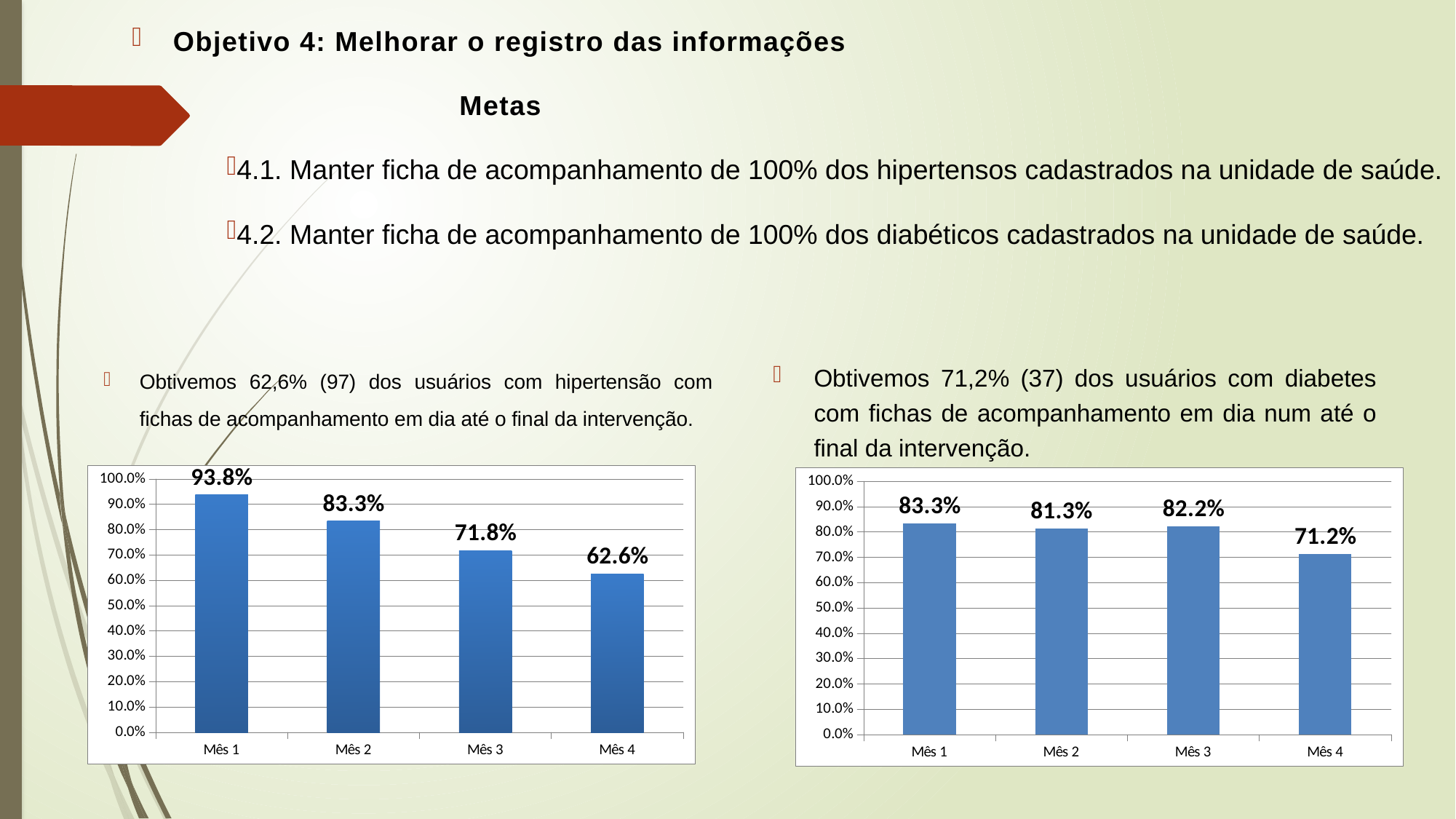
In the left chart, which month has the lowest value? Mês 4 In the right chart, what is the value for Mês 4? 71.2% In the right chart, what is the value for Mês 2? 81.3% In the right chart, which is larger, the value for Mês 3 or the value for Mês 4? Mês 3 In the left chart, what is the value for Mês 1? 93.8% In the left chart, what is the difference between the values for Mês 1 and Mês 4? 31.2 percentage points How many bars does the left chart have? 4 In the left chart, what is the value for Mês 4? 62.6% In the right chart, which month has the highest value? Mês 1 What kind of chart is the right chart? bar chart In the left chart, do the values rise or fall from Mês 1 to Mês 4? fall In the right chart, what is the difference between the values for Mês 1 and Mês 4? 12.1 percentage points